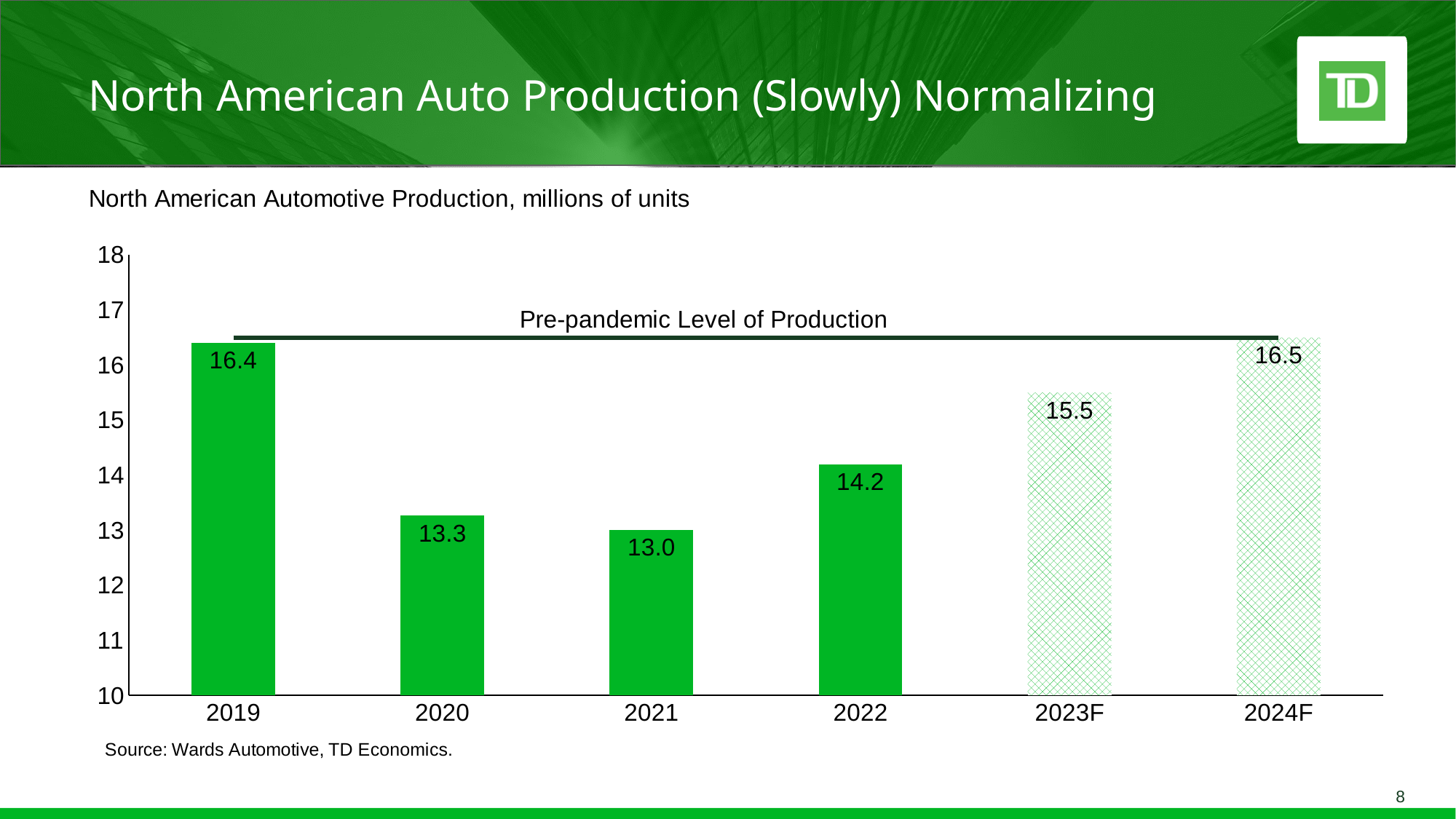
Which is larger, the value for 2020 or the value for 2022? 2022 Is the value for 2023F greater or less than 15? greater Which year has the lowest production value? 2021 How many years are shown on the x axis? 6 What is the value for 2019? 16.4 What is the value for 2021? 13.0 What is the difference between the values for 2024F and 2023F? 1.0 What kind of chart is this? bar chart What is the difference between the values for 2022 and 2020? 0.9 What does the horizontal line across the chart represent? Pre-pandemic Level of Production What is the value for 2023F? 15.5 Which year has the highest production value? 2024F